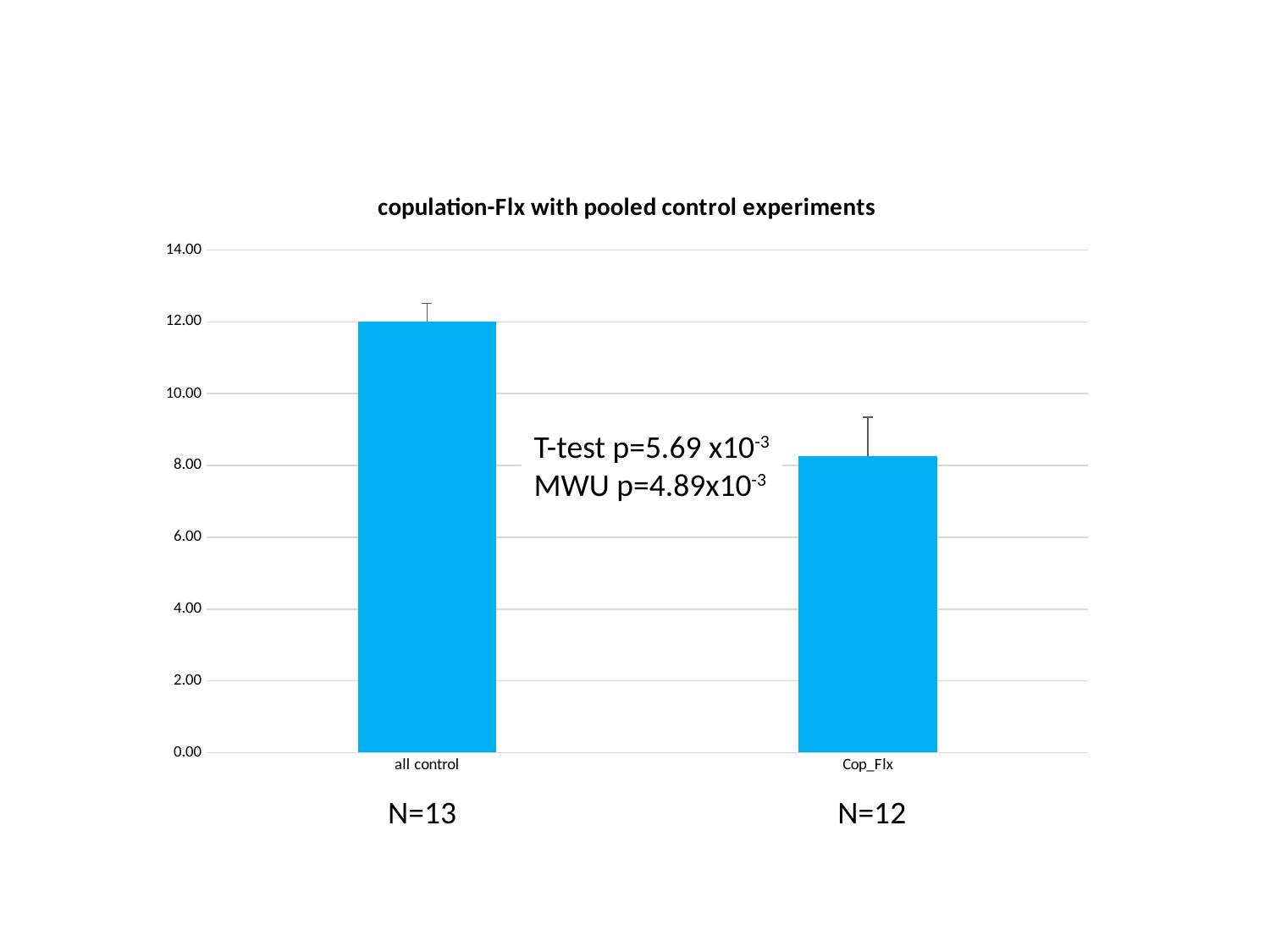
What kind of chart is shown on the slide? bar chart Which is larger, the value for all control or the value for Cop_Flx? all control What sample size (N) is shown under the all control bar? N=13 What is the title of the chart? copulation-Flx with pooled control experiments Is the value for Cop_Flx greater or less than 10.00? less What value does the all control bar reach on the y axis? 12.00 Which category has the lowest bar? Cop_Flx Is the value for all control greater or less than 10.00? greater How many categories are plotted on the x axis? 2 Which category has the highest bar? all control Is the value for Cop_Flx greater or less than 6.00? greater